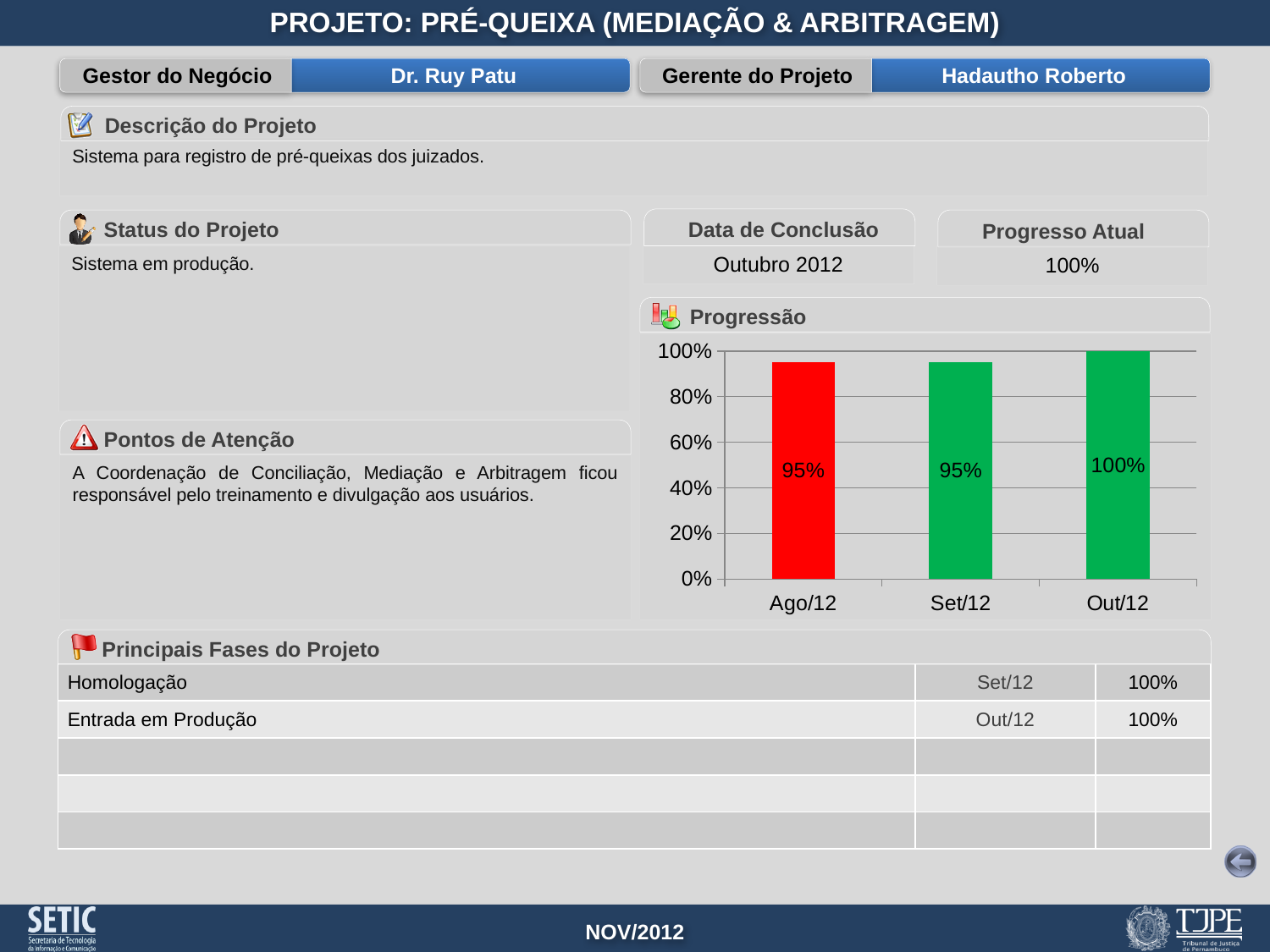
What is the value for Out/12 in the Progressão chart? 100% Which is larger in the Progressão chart, the value for Out/12 or the value for Set/12? Out/12 What colour is the bar for Ago/12 in the Progressão chart? red What is the difference between the values for Out/12 and Ago/12 in the Progressão chart? 5% What is the title of the chart on the slide? Progressão What is the value for Set/12 in the Progressão chart? 95% How many months are shown on the x axis of the Progressão chart? 3 Is the value for Ago/12 in the Progressão chart greater or less than 80%? greater What is the value for Ago/12 in the Progressão chart? 95% Which month has the highest value in the Progressão chart? Out/12 Do the values in the Progressão chart rise or fall from Ago/12 to Out/12? rise What kind of chart is the Progressão chart? bar chart